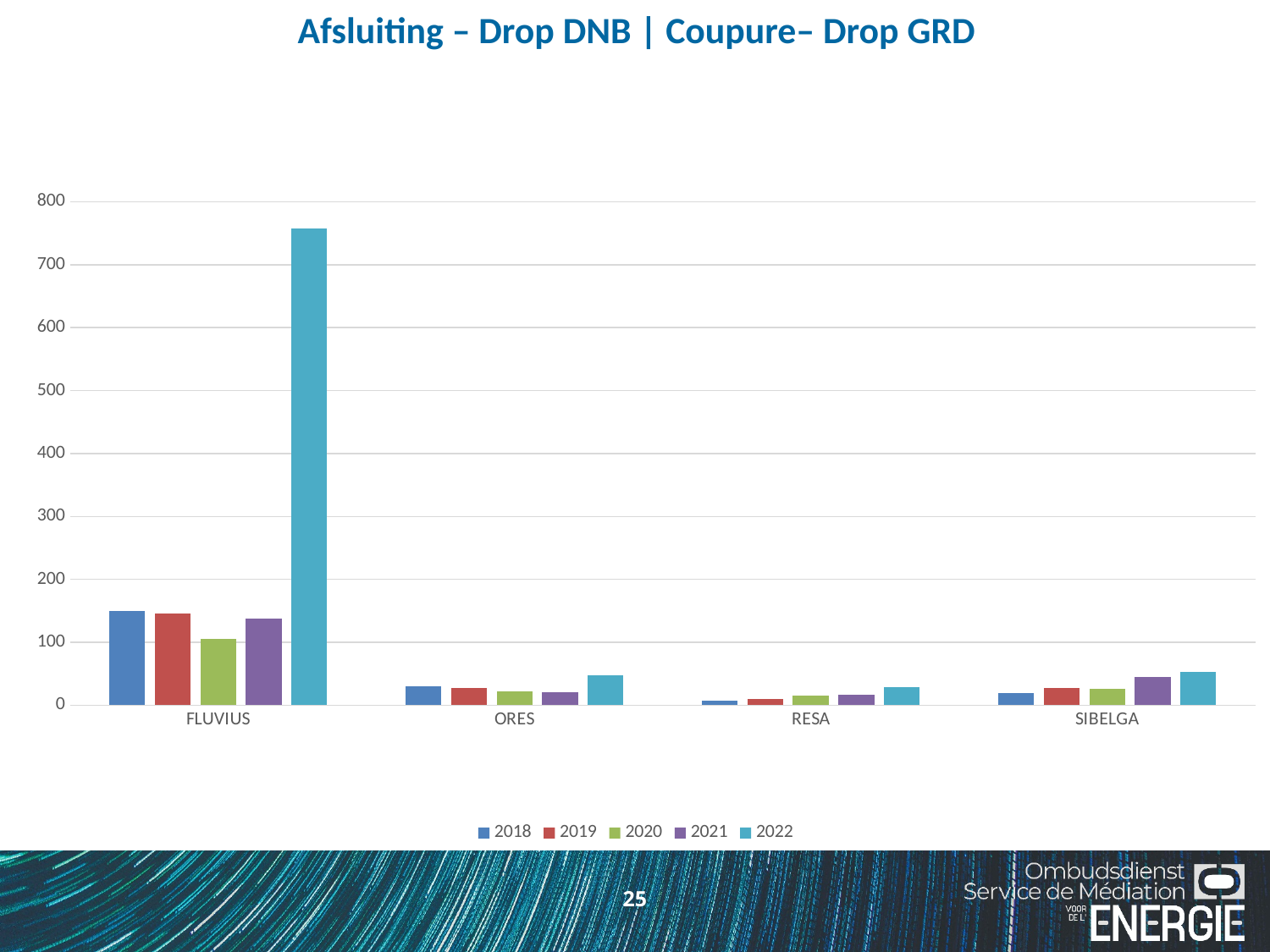
How many series does the legend list? 5 Which category has the highest bar for 2022? FLUVIUS Which is larger, the 2022 value for FLUVIUS or the 2022 value for ORES? FLUVIUS What kind of chart is shown on the slide? Bar chart Is the value for FLUVIUS in 2018 greater or less than 100? greater How many categories are shown on the x axis? 4 Do the values for RESA rise or fall from 2018 to 2022? rise Which is larger, the 2021 value for SIBELGA or the 2021 value for ORES? SIBELGA Is the value for FLUVIUS in 2022 greater or less than 700? greater Which category has the lowest bar for 2018? RESA What is the title of the slide? Afsluiting – Drop DNB | Coupure– Drop GRD Is the value for FLUVIUS in 2020 greater or less than 200? less